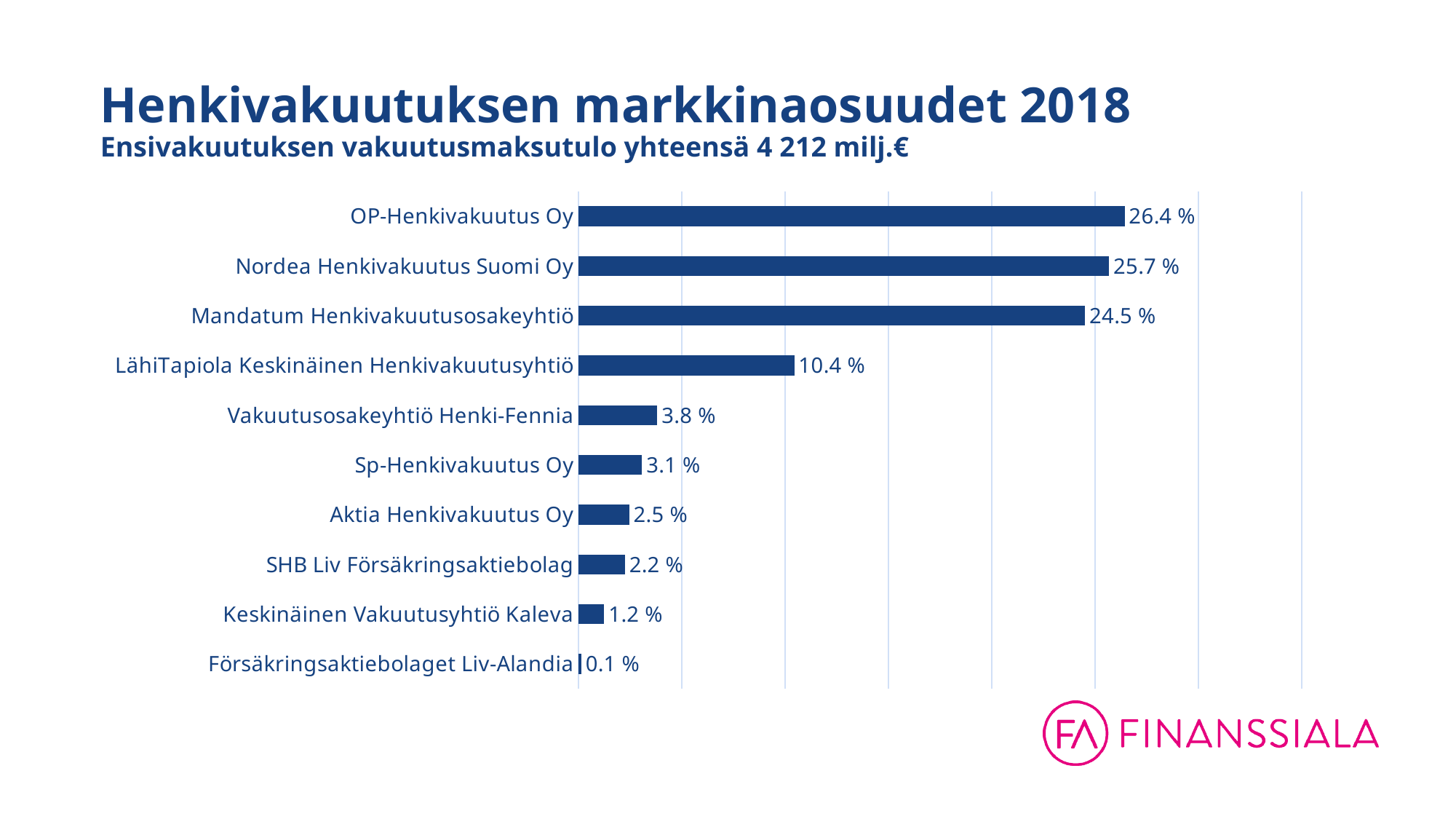
What is the difference in market share between Vakuutusosakeyhtiö Henki-Fennia and Sp-Henkivakuutus Oy? 0.7 % What is the difference in market share between Nordea Henkivakuutus Suomi Oy and Mandatum Henkivakuutusosakeyhtiö? 1.2 % What is the market share of LähiTapiola Keskinäinen Henkivakuutusyhtiö? 10.4 % What kind of chart is shown on the slide? Bar chart What total premium income is stated in the subtitle? 4 212 milj.€ Which has a larger market share, SHB Liv Försäkringsaktiebolag or Keskinäinen Vakuutusyhtiö Kaleva? SHB Liv Försäkringsaktiebolag What is the market share of Aktia Henkivakuutus Oy? 2.5 % How many companies are shown in the chart? 10 Which company has the largest market share? OP-Henkivakuutus Oy What is the market share of OP-Henkivakuutus Oy? 26.4 % Which company has the smallest market share? Försäkringsaktiebolaget Liv-Alandia What is the title of the slide? Henkivakuutuksen markkinaosuudet 2018